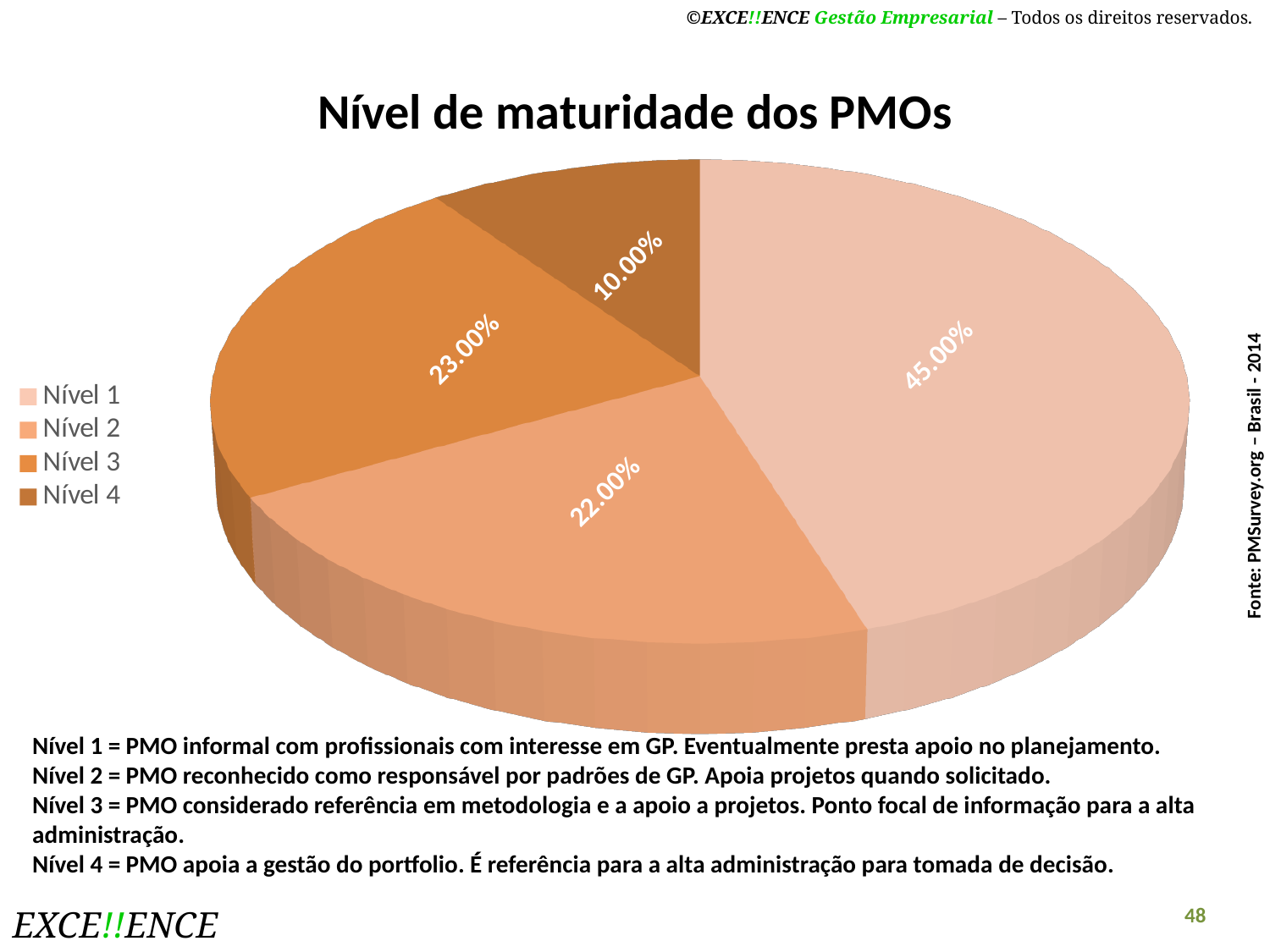
What percentage of the pie corresponds to Nível 2? 22.00% How many slices does the pie chart have? 4 How many entries does the legend list? 4 What kind of chart is shown on the slide? pie chart What is the title of the chart? Nível de maturidade dos PMOs Which is larger, the share for Nível 2 or the share for Nível 3? Nível 3 Which level has the largest share of the pie? Nível 1 What is the difference in percentage points between Nível 1 and Nível 4? 35.00% Which level has the smallest share of the pie? Nível 4 What percentage of the pie corresponds to Nível 3? 23.00% What percentage of the pie corresponds to Nível 4? 10.00% What percentage of the pie corresponds to Nível 1? 45.00%